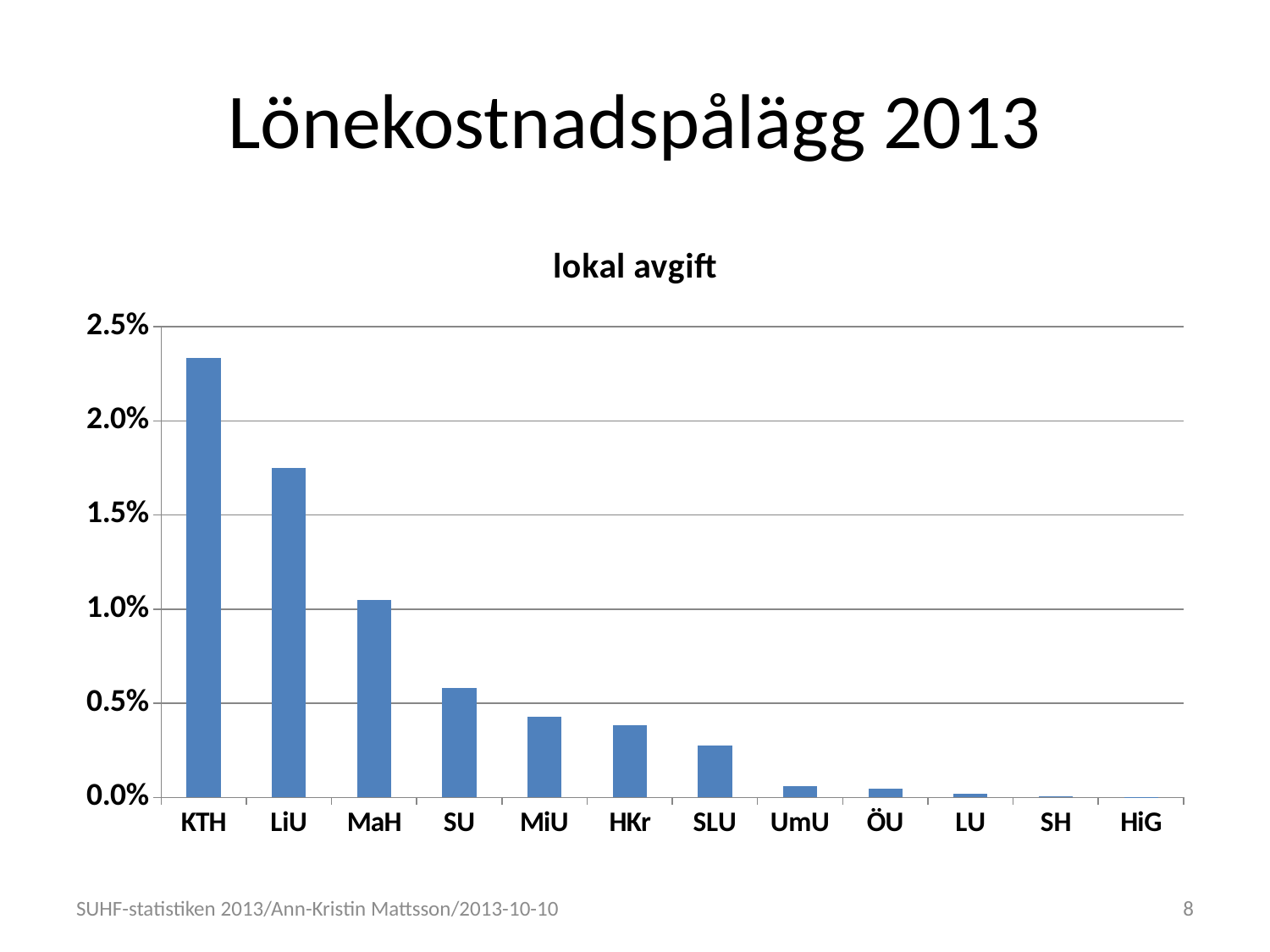
Is the value for SU greater or less than 0.5%? greater Which category has the highest value in the chart? KTH Is the value for MaH greater or less than 1.5%? less Which is larger, the value for KTH or the value for LiU? KTH How many categories are shown on the x axis of the chart? 12 Is the value for MiU greater or less than 0.5%? less Do the values rise or fall moving from left to right along the x axis? fall What is the title of the chart? lokal avgift Which is larger, the value for SLU or the value for MaH? MaH What kind of chart is shown on the slide? bar chart